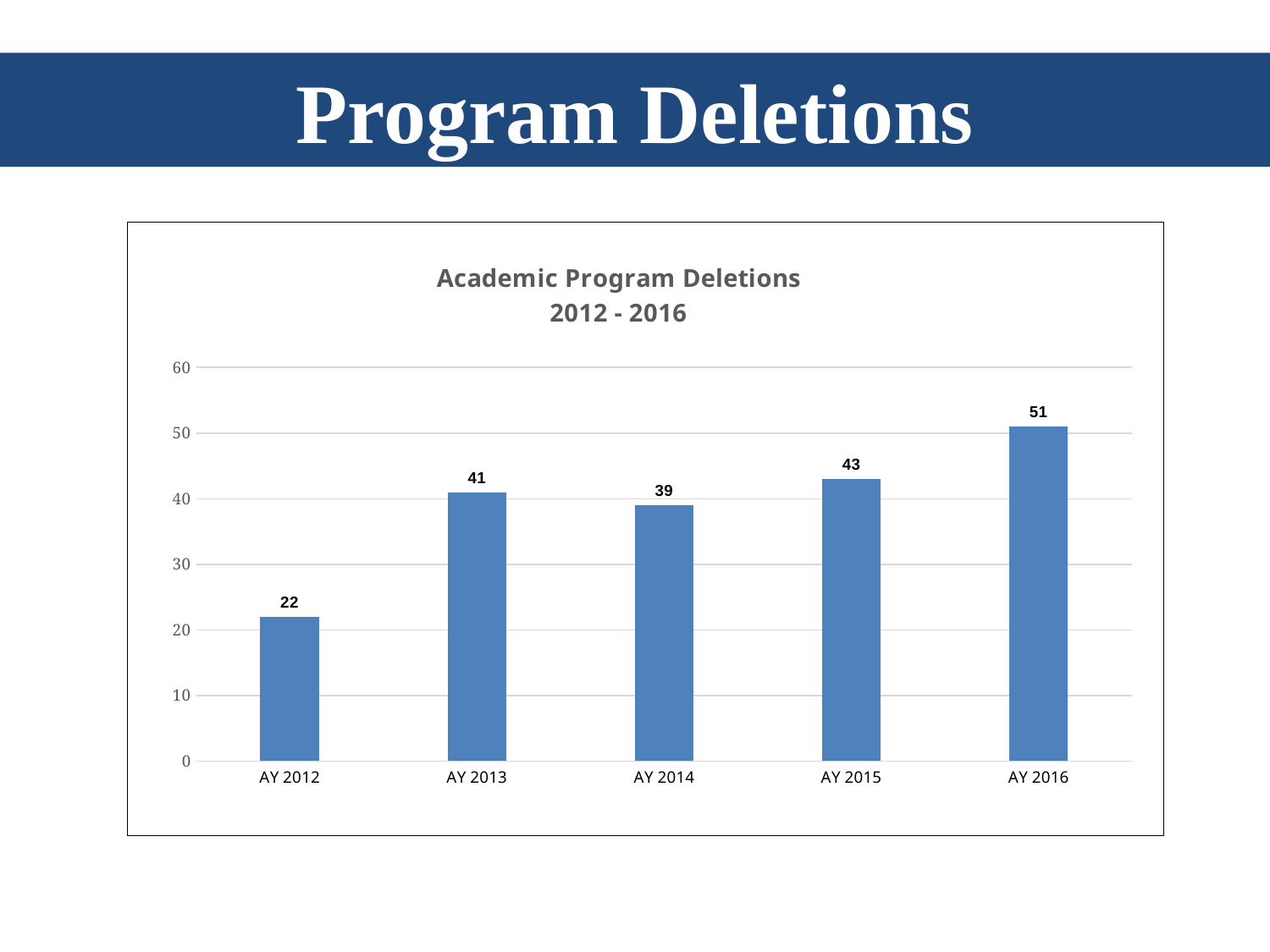
Which academic year has the highest number of program deletions? AY 2016 Is the value for AY 2016 greater or less than 50? greater What is the title of the chart? Academic Program Deletions 2012 - 2016 Which is larger, the value for AY 2015 or the value for AY 2013? AY 2015 What is the value for AY 2016? 51 How many academic years are shown on the chart? 5 What is the difference between the values for AY 2013 and AY 2014? 2 What is the value for AY 2012? 22 What is the difference between the values for AY 2016 and AY 2012? 29 Which academic year has the lowest number of program deletions? AY 2012 What kind of chart is shown on the slide? bar chart What is the value for AY 2014? 39